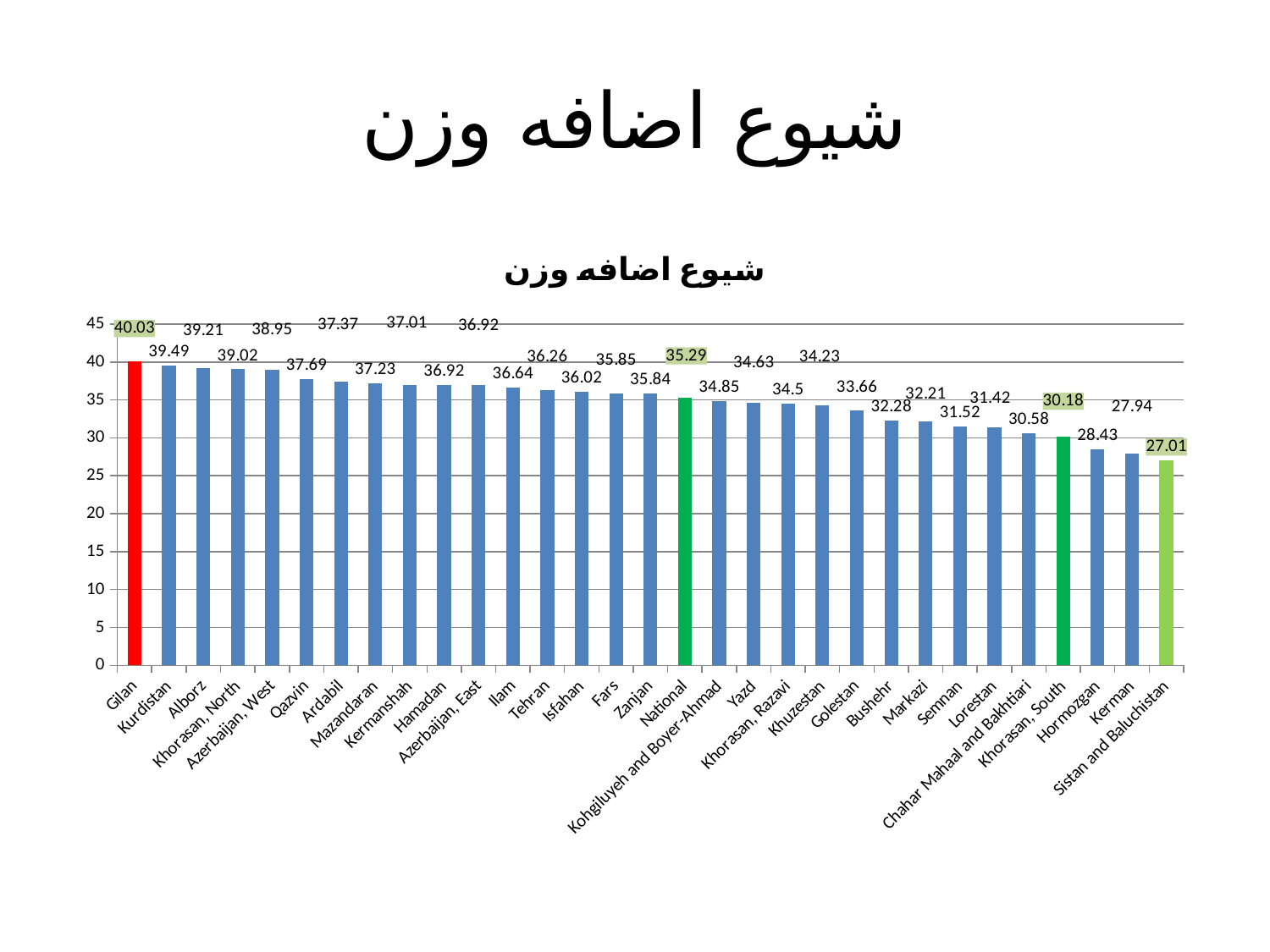
What is the value for Sistan and Baluchistan? 27.01 What is the value for Tehran? 36.26 Which category has the lowest value? Sistan and Baluchistan Do the values rise or fall from left to right along the x axis? Fall What is the value for National? 35.29 What is the difference between the values for National and Khorasan, South? 5.11 What kind of chart is this? Bar chart Which category has the highest value? Gilan Which is larger, the value for Tehran or the value for Yazd? Tehran What is the difference between the values for Gilan and Sistan and Baluchistan? 13.02 How many categories are shown on the x axis? 31 What is the value for Gilan? 40.03